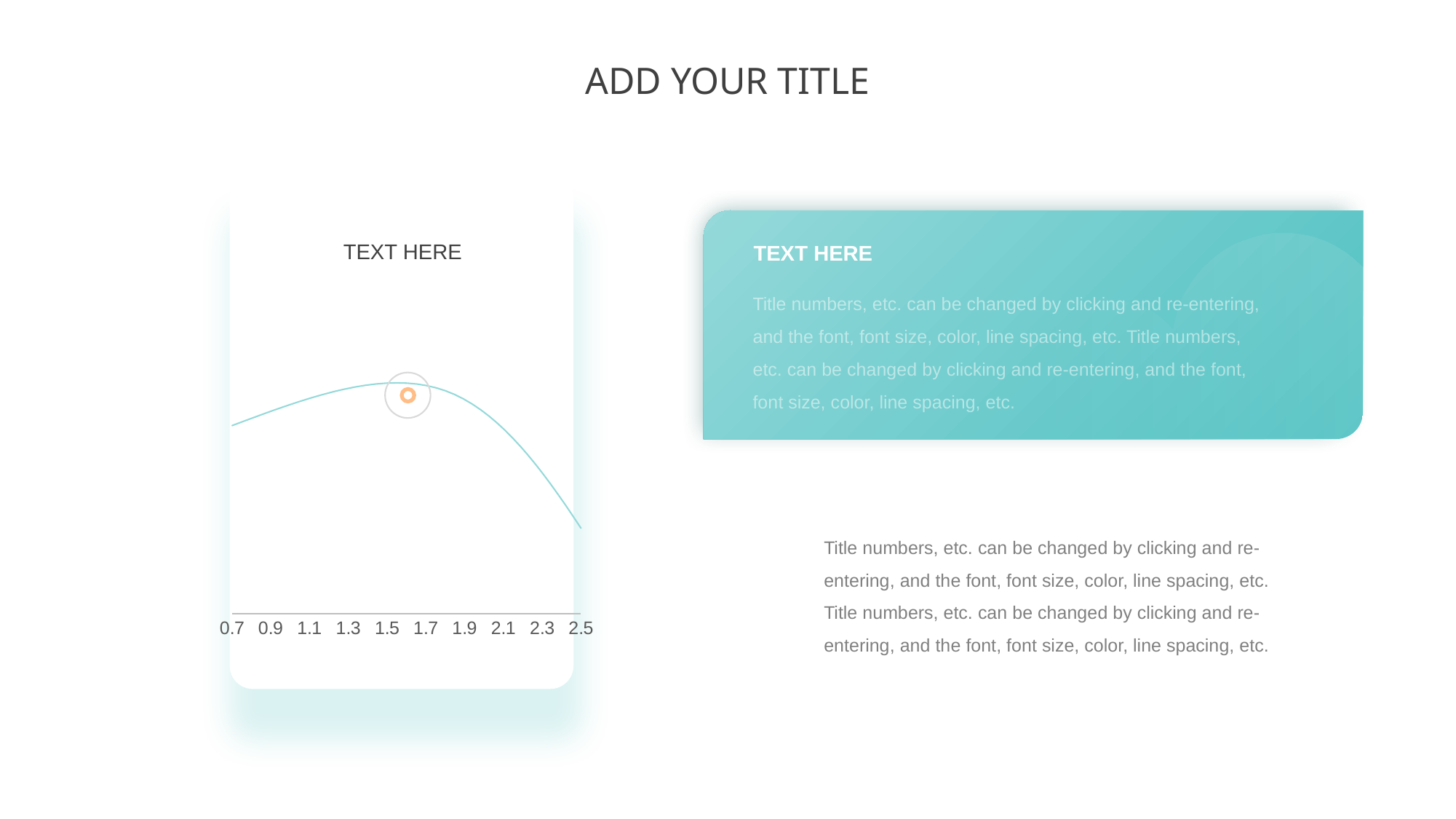
Which is higher on the chart, the line's value at 1.5 or at 2.3? 1.5 What is the last label on the x axis of the chart? 2.5 What kind of chart is shown on the slide? line chart At which x-axis label does the line reach its lowest point? 2.5 How many tick labels are shown on the x axis of the chart? 10 How many lines are plotted on the chart? 1 Does the line rise or fall between x = 1.7 and x = 2.5? falls Does the line rise or fall between x = 0.7 and x = 1.5? rises Which is higher on the chart, the line's value at 0.7 or at 2.5? 0.7 What is the title of the chart? TEXT HERE What is the first label on the x axis of the chart? 0.7